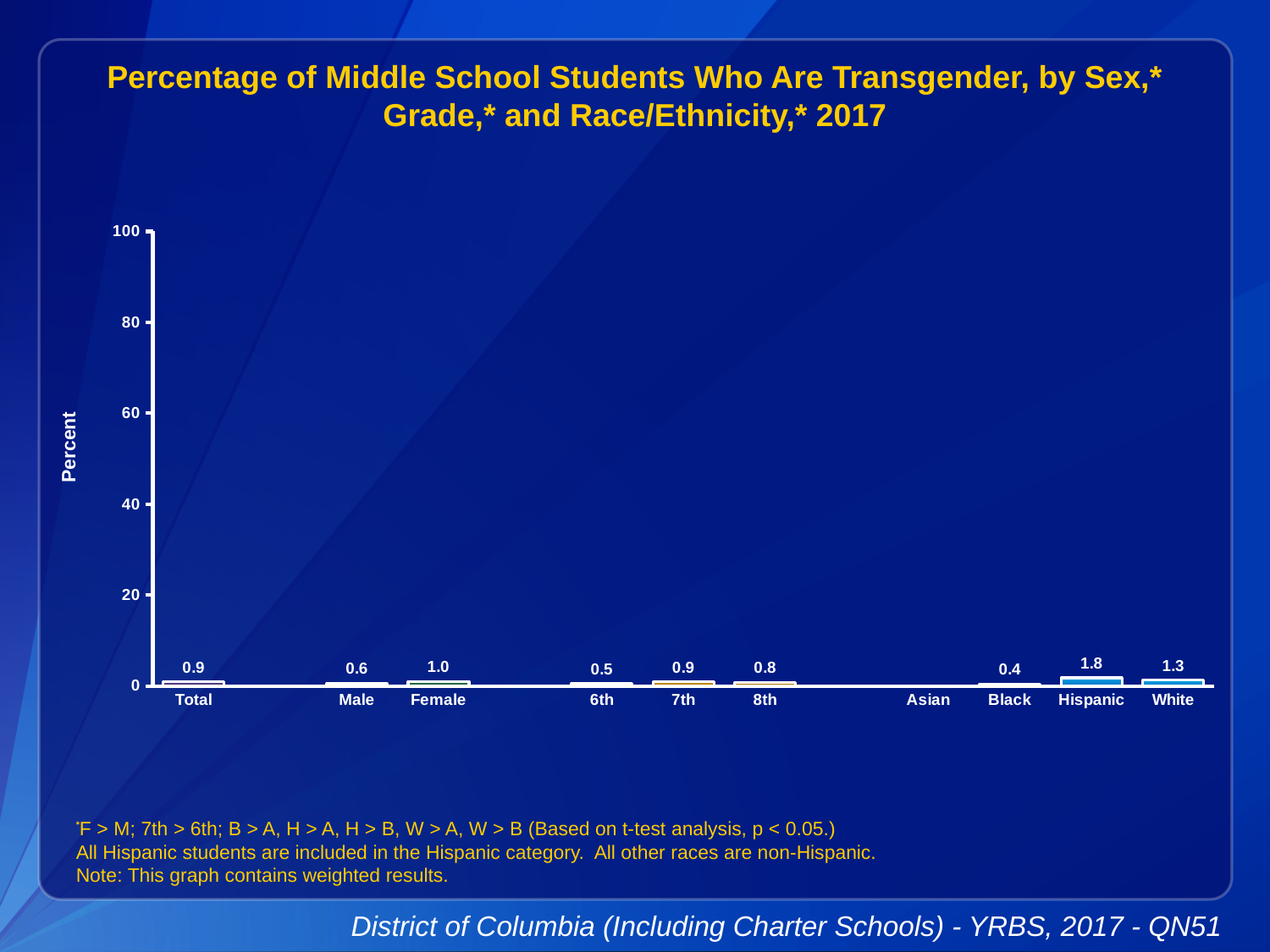
What is the value for Total? 0.9 What is the difference between the values for Hispanic and White? 0.5 What is the label on the y axis? Percent Which is larger, the value for Female or the value for Male? Female What is the value for Black? 0.4 Which category has the highest value? Hispanic What kind of chart is shown on the slide? bar chart What is the difference between the values for Female and Male? 0.4 Is the value for White greater or less than 20? less What is the value for Hispanic? 1.8 Among the grade categories (6th, 7th, 8th), which has the lowest value? 6th What is the value for 6th grade? 0.5